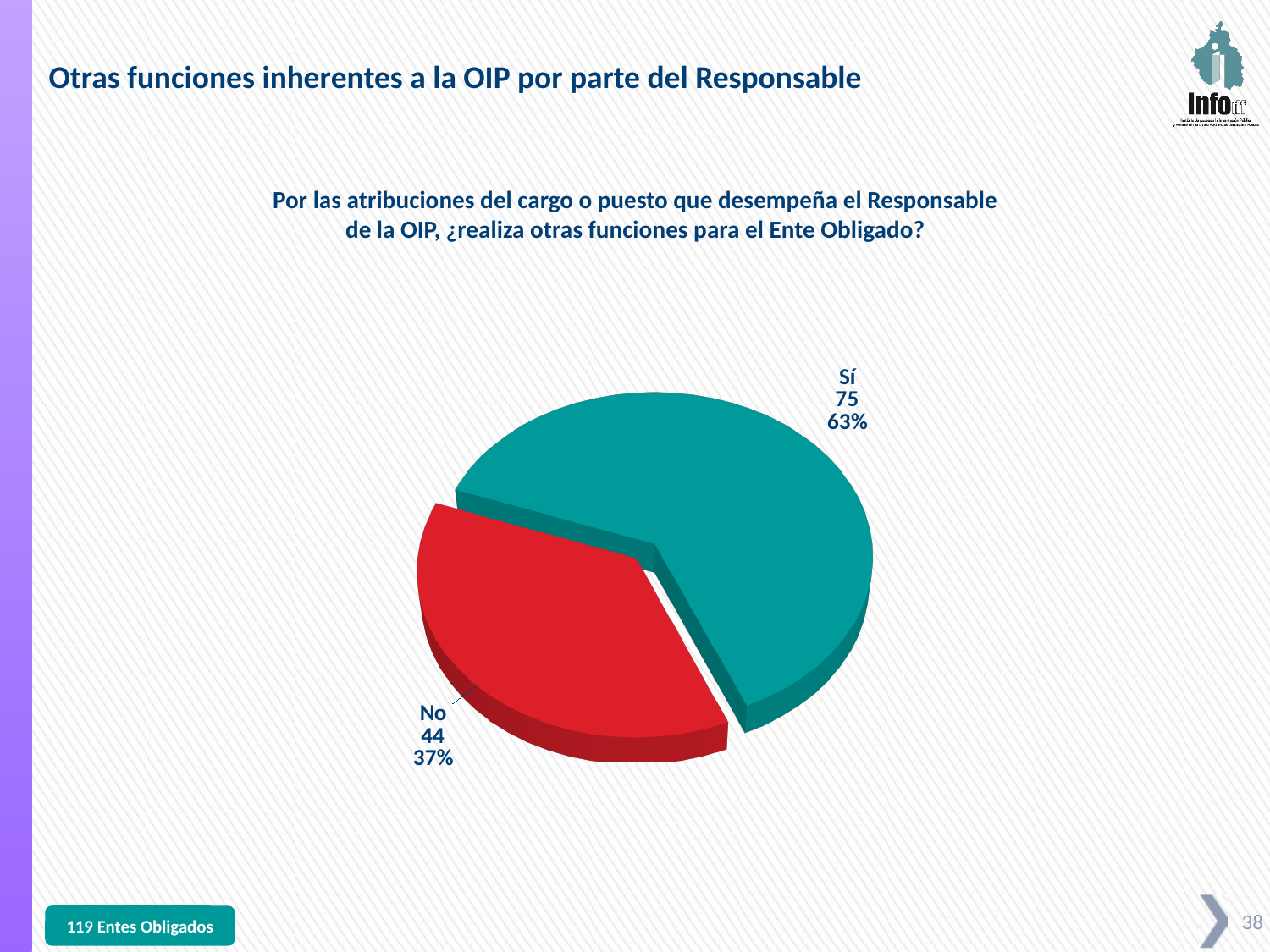
Which slice is the largest? Sí What share of the pie does the "Sí" slice represent? 63% What is the count for the "Sí" slice? 75 How many slices does the pie chart have? 2 What share of the pie does the "No" slice represent? 37% What is the difference between the counts for "Sí" and "No"? 31 Which slice is the smallest? No What is the total of the two slice counts? 119 What is the count for the "No" slice? 44 Which is larger, the "Sí" slice or the "No" slice? Sí What kind of chart is shown on the slide? pie chart What colour is the "No" slice? red